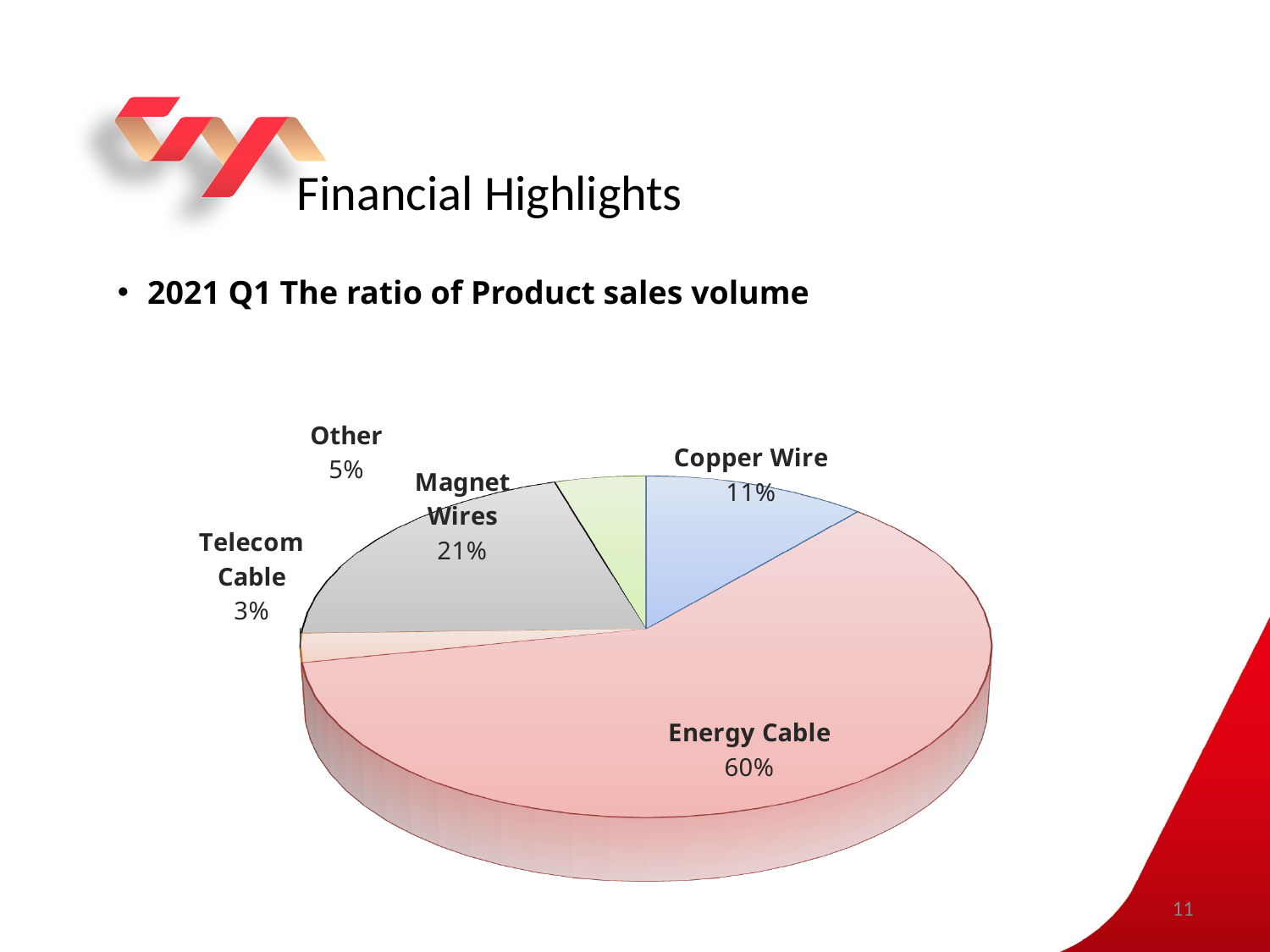
Which product category has the largest share of sales volume? Energy Cable What is the difference in percentage points between Copper Wire and Other? 6 What percentage of the pie is Magnet Wires? 21% What type of chart is shown on the slide? Pie chart What percentage is shown for Telecom Cable? 3% What is the difference in percentage points between Energy Cable and Magnet Wires? 39 What share of product sales volume does Energy Cable account for? 60% How many product categories are shown in the pie chart? 5 Which has a larger share, Magnet Wires or Copper Wire? Magnet Wires Which product category has the smallest share of sales volume? Telecom Cable What period does the chart's bullet heading say the sales volume ratio refers to? 2021 Q1 What is the value shown for Copper Wire? 11%